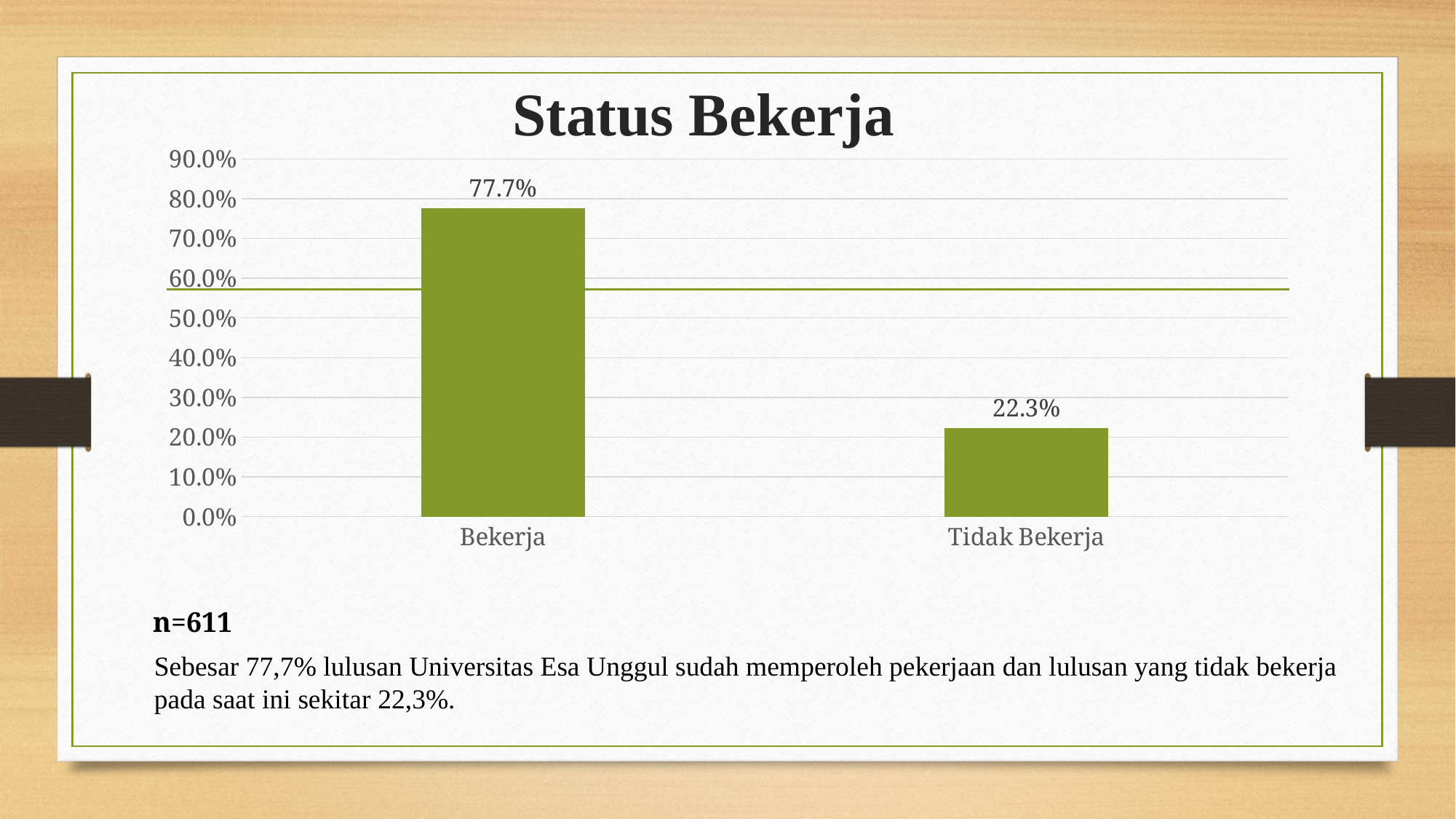
What kind of chart is shown on the slide? bar chart Is the value for Tidak Bekerja greater or less than 30.0%? less Which category has the lowest value? Tidak Bekerja What is the highest value shown on the y axis? 90.0% What is the difference between the values for Bekerja and Tidak Bekerja? 55.4% What is the title of the chart? Status Bekerja What is the value for Tidak Bekerja? 22.3% Is the value for Bekerja greater or less than 70.0%? greater Which category has the highest value? Bekerja What is the value for Bekerja? 77.7% How many categories are shown on the x axis? 2 Which is larger, the value for Bekerja or the value for Tidak Bekerja? Bekerja